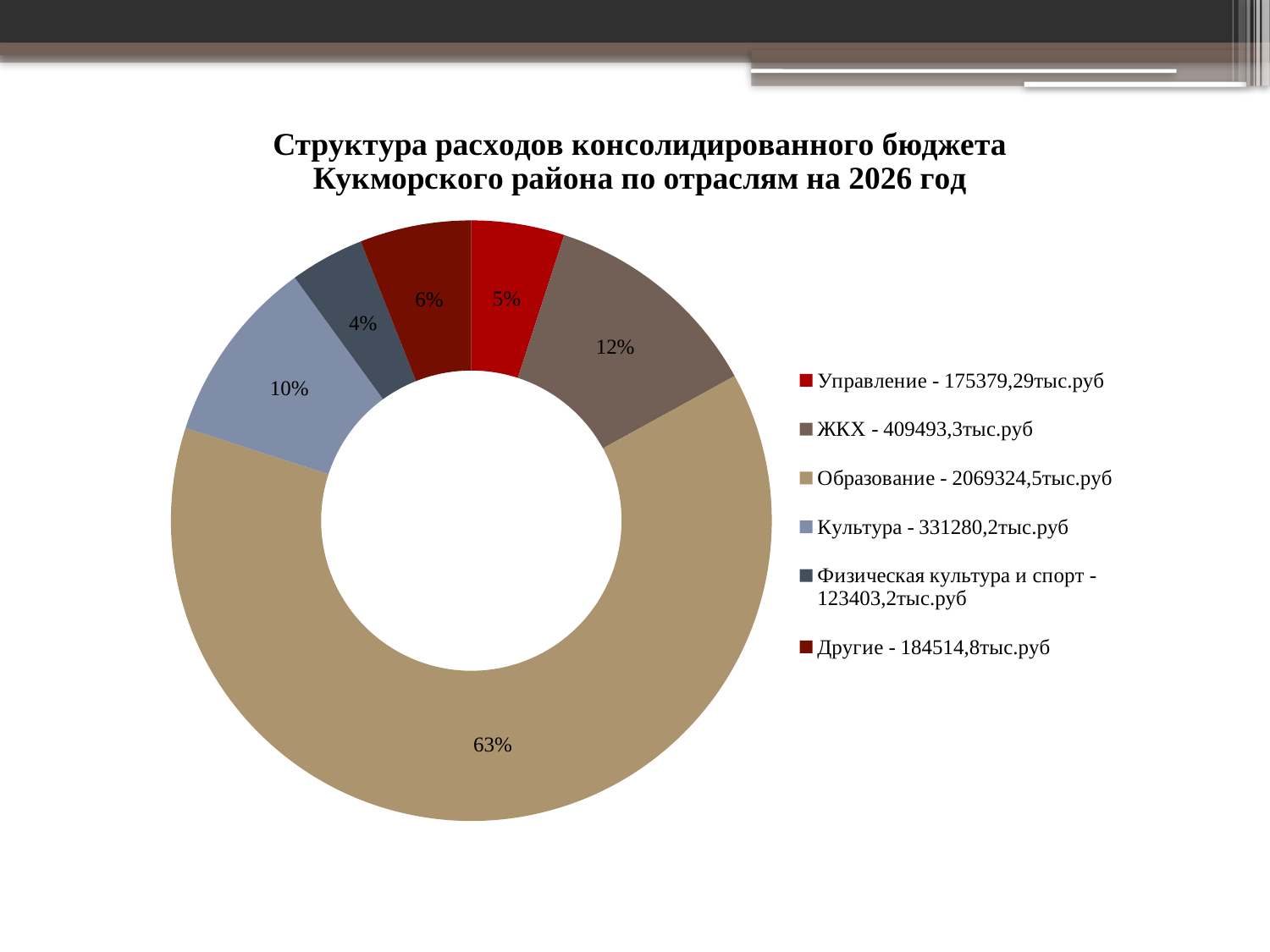
According to the legend, what is the amount for Образование in тыс.руб? 2069324,5тыс.руб How many categories are shown in the chart? 6 What percentage is shown for the Физическая культура и спорт slice? 4% Which slice is larger, Управление or Другие? Другие What is the difference in percentage points between the Образование slice and the ЖКХ slice? 51% What percentage is shown for the ЖКХ slice? 12% What is the title of the chart? Структура расходов консолидированного бюджета Кукморского района по отраслям на 2026 год What percentage is shown for the Культура slice? 10% Which category has the largest share of the chart? Образование What share of the chart does Образование account for? 63% Which category has the smallest share of the chart? Физическая культура и спорт What kind of chart is shown on the slide? doughnut chart